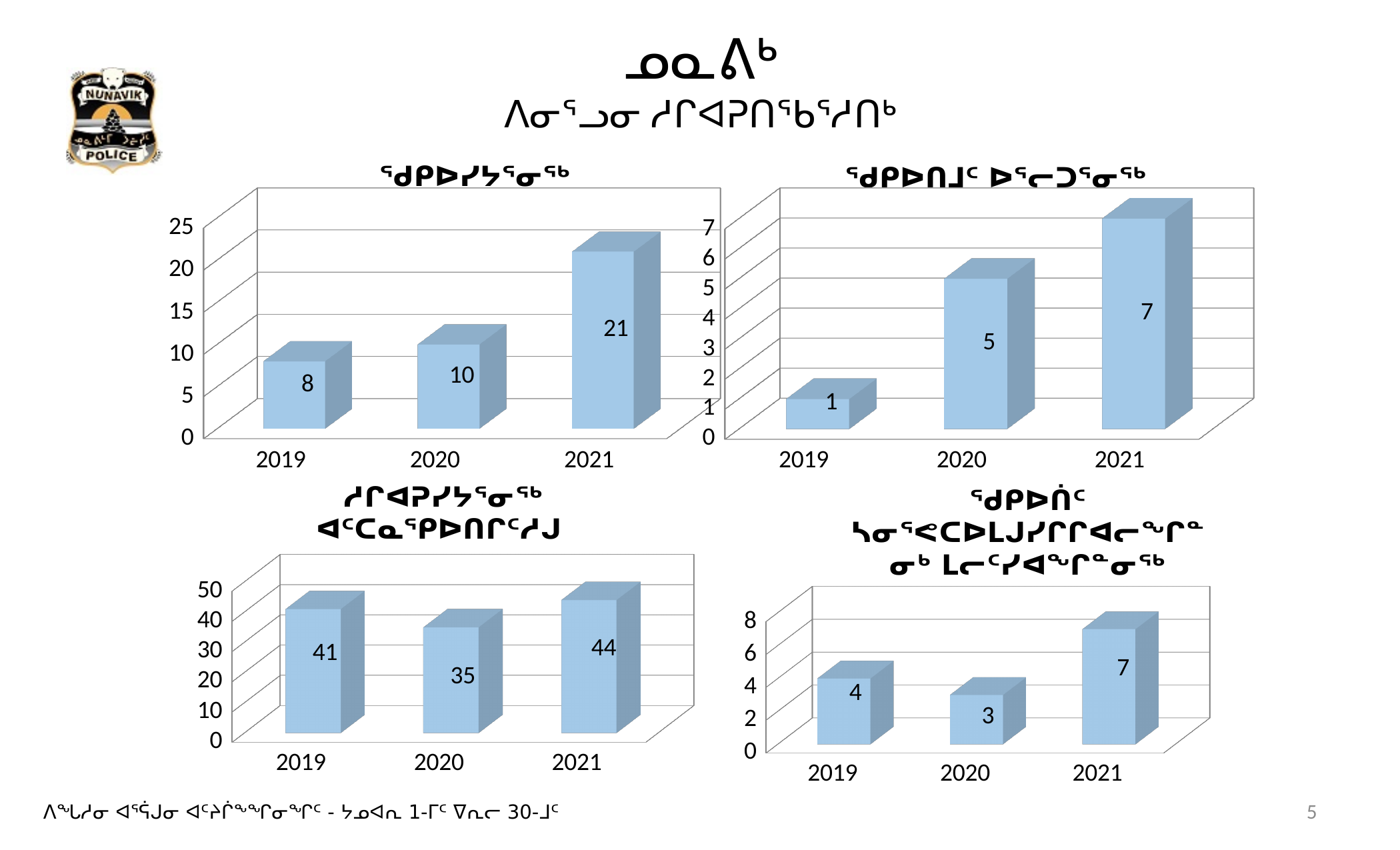
In the top-left chart, what is the value for 2021? 21 In the bottom-right chart, what is the value for 2021? 7 In the top-right chart, which year has the lowest value? 2019 In the top-left chart, what is the difference between the values for 2021 and 2020? 11 In the top-right chart, do the values rise or fall from 2019 to 2021? rise In the top-left chart, what is the value for 2019? 8 In the bottom-right chart, which is larger, the value for 2019 or the value for 2020? 2019 In the bottom-left chart, which year has the highest value? 2021 In the top-right chart, what is the value for 2020? 5 How many charts are on the slide, and what type are they? 4 bar charts In the bottom-left chart, what is the difference between the values for 2021 and 2019? 3 In the bottom-left chart, what is the value for 2020? 35